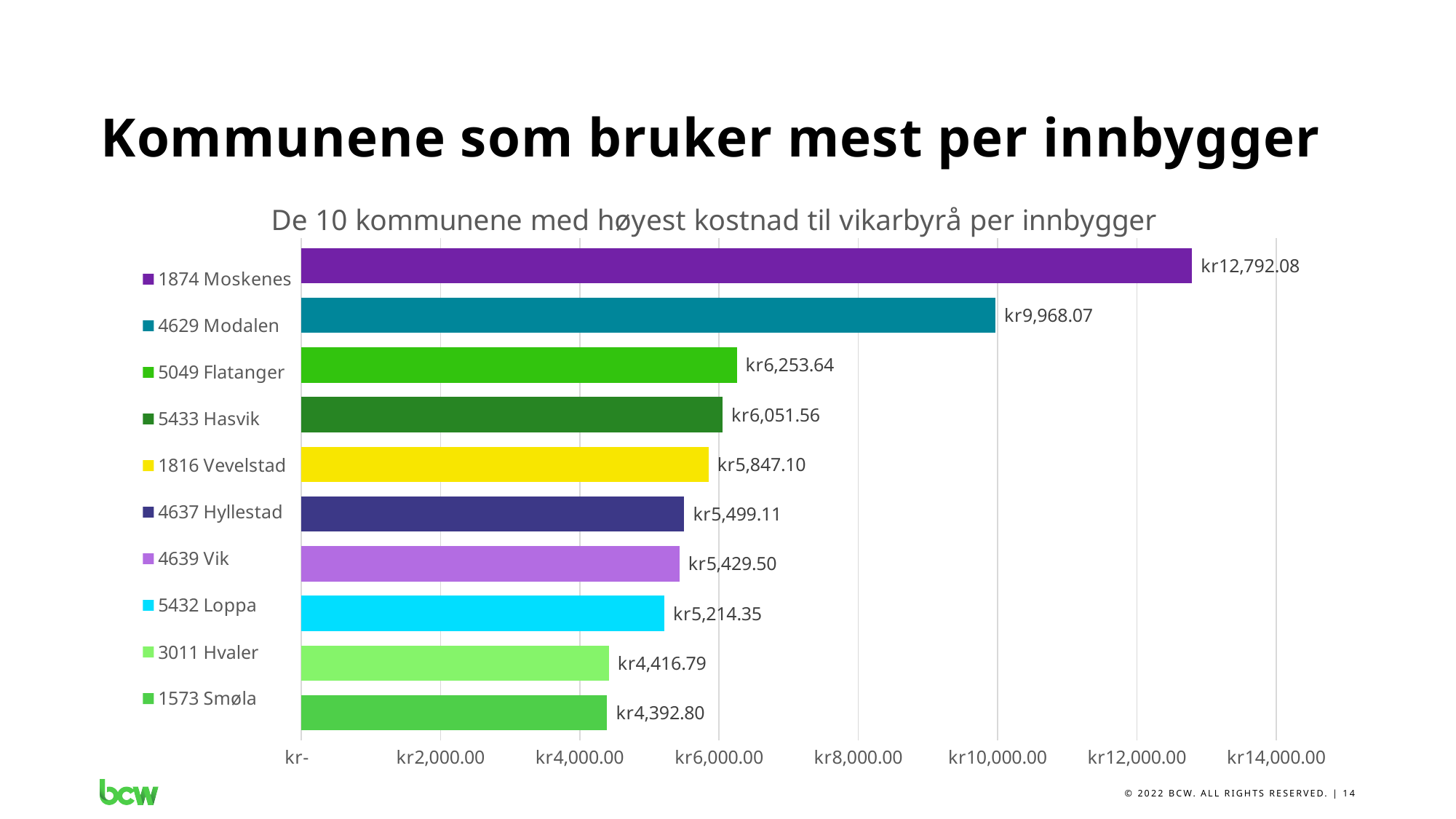
What is the value for 1816 Vevelstad? kr5,847.10 What is the value for 1573 Smøla? kr4,392.80 Is the value for 4629 Modalen greater or less than kr8,000.00? greater What is the difference between the values for 1874 Moskenes and 4629 Modalen? kr2,824.01 How many municipalities are shown on the chart? 10 What is the value for 1874 Moskenes? kr12,792.08 What is the value for 4629 Modalen? kr9,968.07 What is the title of the chart? De 10 kommunene med høyest kostnad til vikarbyrå per innbygger What kind of chart is shown on the slide? Bar chart Which municipality has the lowest value on the chart? 1573 Smøla Which municipality has the highest cost per inhabitant? 1874 Moskenes Which has the larger value, 5049 Flatanger or 5433 Hasvik? 5049 Flatanger